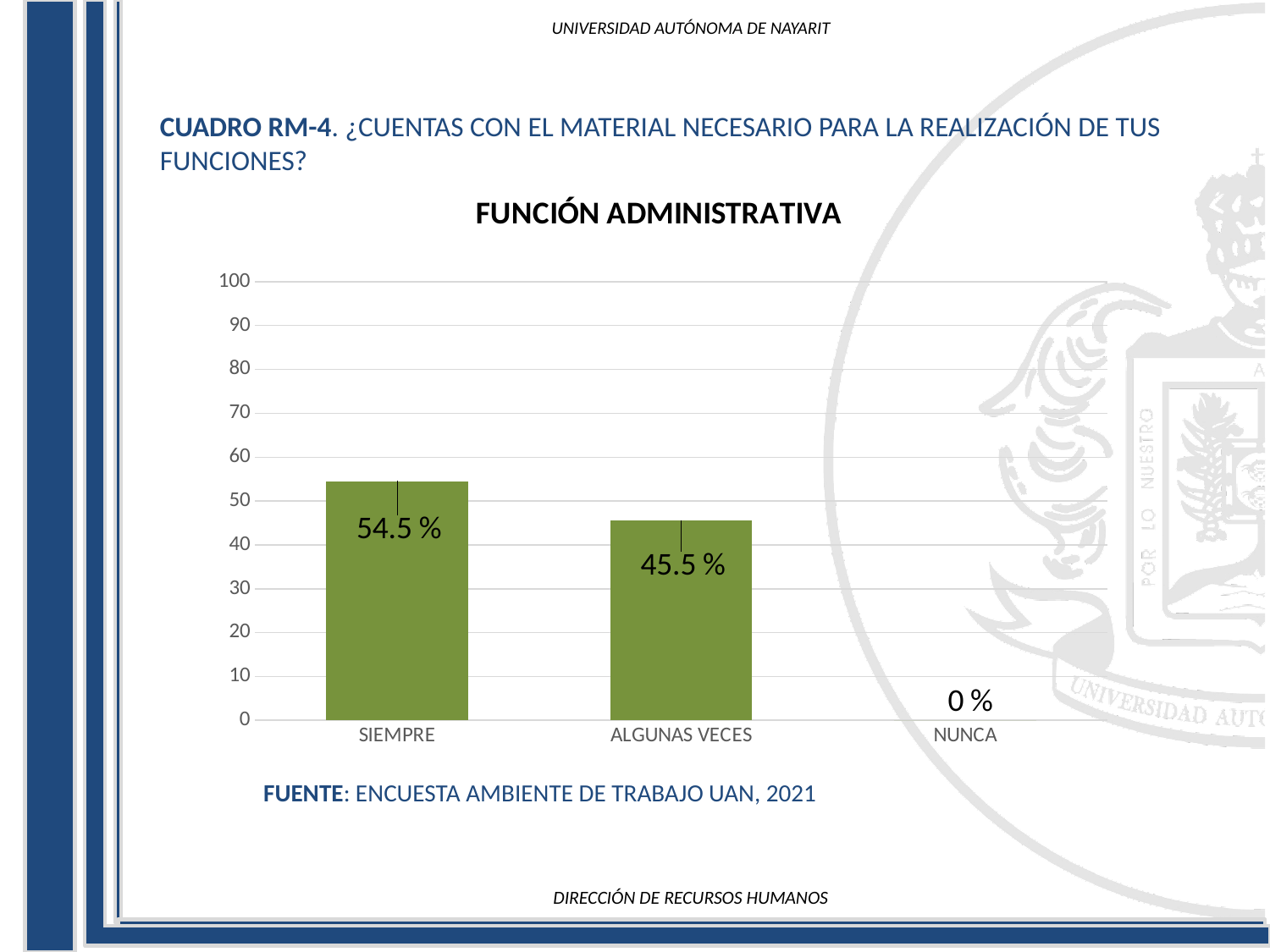
What is the value for SIEMPRE? 54.5 % Is the value for ALGUNAS VECES greater or less than 50? less What is the title of the chart? FUNCIÓN ADMINISTRATIVA Is the value for SIEMPRE greater or less than 50? greater What is the value for ALGUNAS VECES? 45.5 % How many categories are shown on the x axis? 3 What kind of chart is shown on the slide? bar chart Which is larger, the value for SIEMPRE or the value for ALGUNAS VECES? SIEMPRE Which category has the highest value? SIEMPRE What is the difference between the values for SIEMPRE and ALGUNAS VECES? 9 % What is the value for NUNCA? 0 % Which category has the lowest value? NUNCA